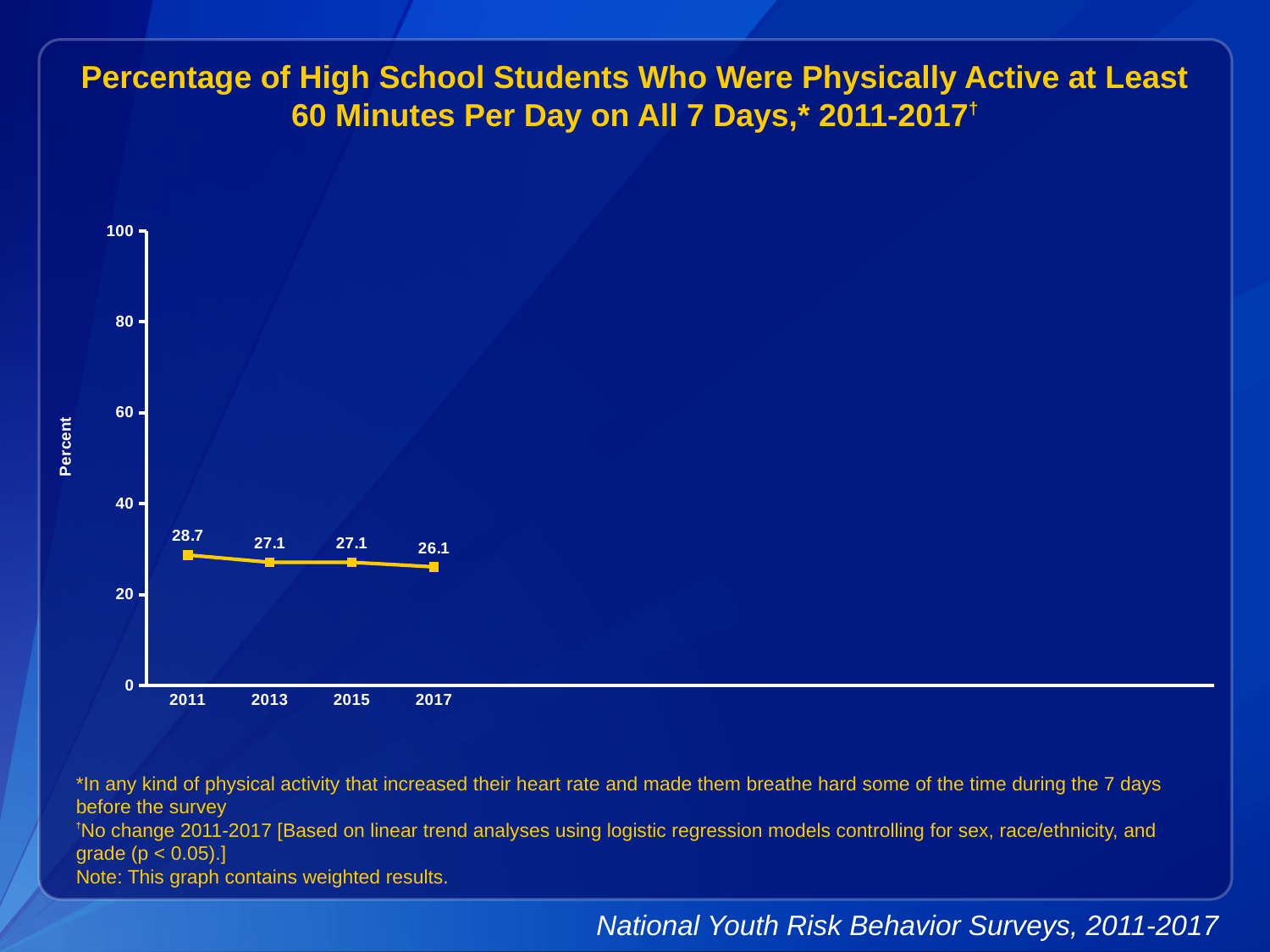
What kind of chart is shown on the slide? line chart What was the percentage of high school students who were physically active at least 60 minutes per day on all 7 days in 2011? 28.7 What value is shown for 2013? 27.1 Do the values rise or fall from 2011 to 2017? fall What is the label on the y axis? Percent How many years are plotted on the chart? 4 Which year has the lowest value? 2017 Which is larger, the value for 2011 or the value for 2013? 2011 Which year has the highest value? 2011 What value is shown for 2017? 26.1 Is the value for 2015 greater or less than 40? less What is the difference between the 2011 value and the 2017 value? 2.6